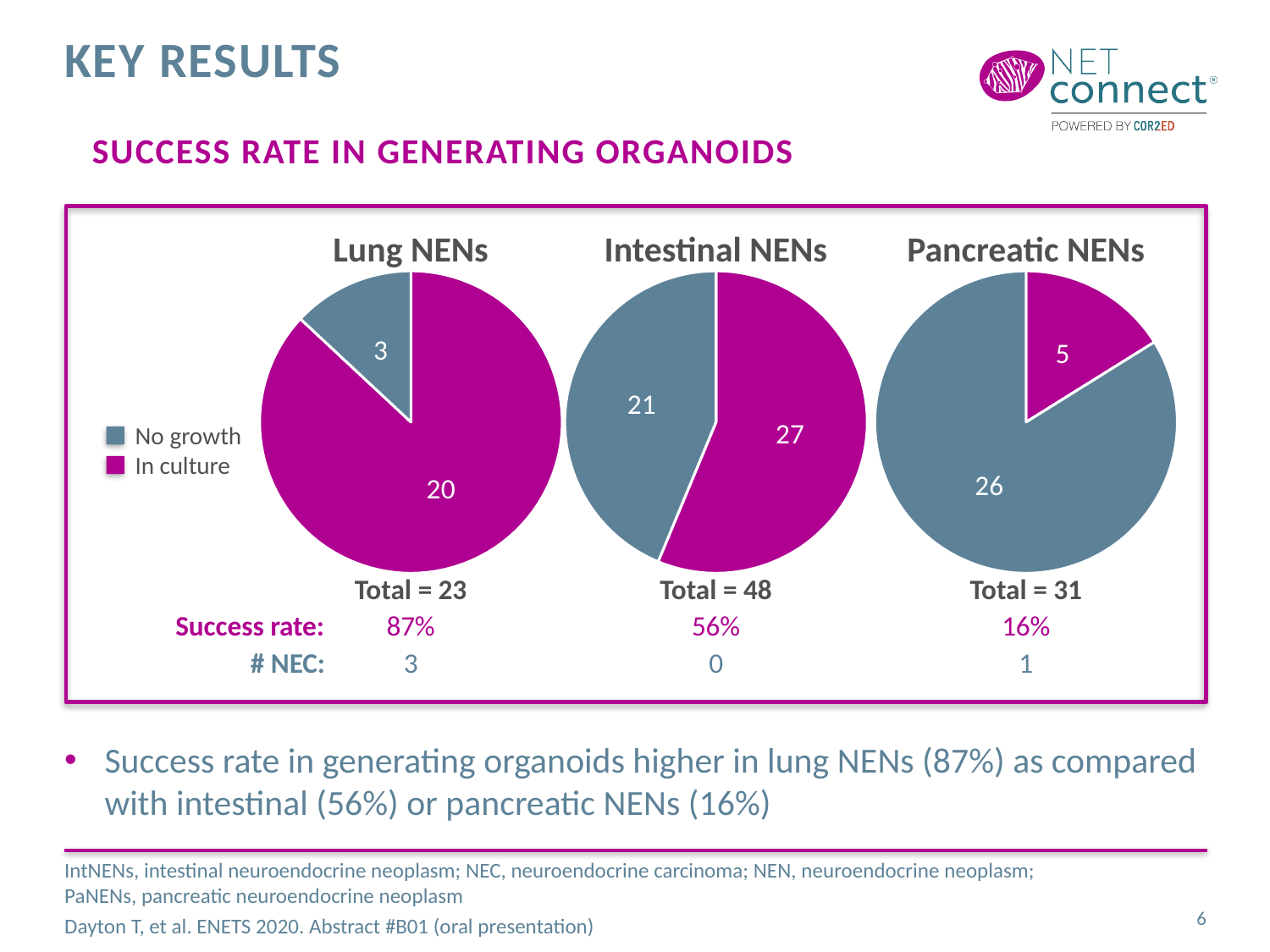
What kind of chart is used to show the success rate in generating organoids? Pie chart How many pie charts are shown on the slide? 3 In the Pancreatic NENs pie chart, how many samples are in culture? 5 What is the total number of samples shown for the Pancreatic NENs pie chart? 31 In the Lung NENs pie chart, what is the difference between the In culture and No growth counts? 17 What is the total number of samples shown for the Intestinal NENs pie chart? 48 Which colour represents In culture in the pie charts? Magenta In the Pancreatic NENs pie chart, which slice is larger, No growth or In culture? No growth In the Intestinal NENs pie chart, how many samples showed no growth? 21 In the Intestinal NENs pie chart, what is the difference between the In culture and No growth counts? 6 How many series does the legend list for the pie charts? 2 In the Lung NENs pie chart, how many samples are in culture? 20